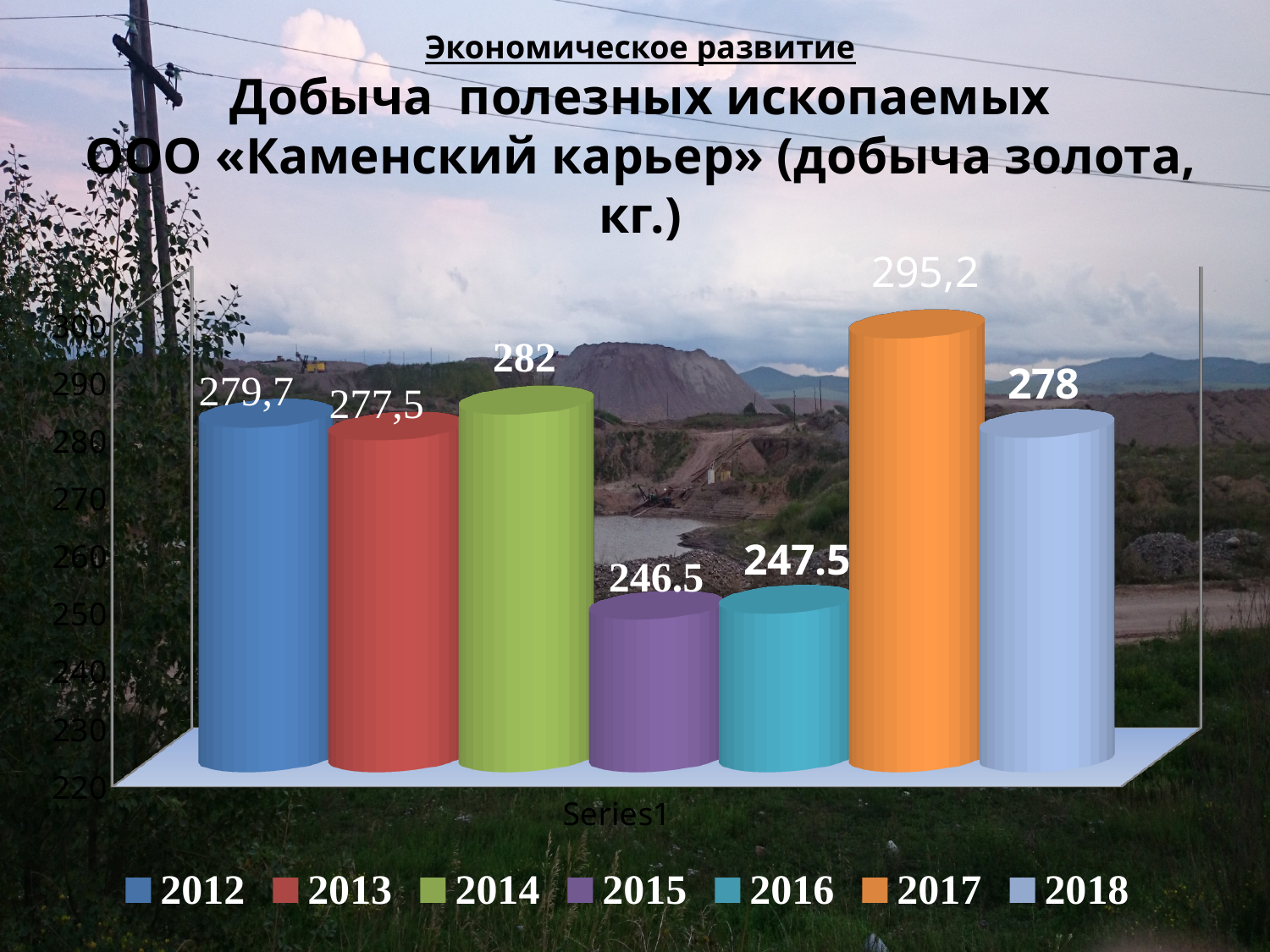
What is the value for 2015? 246.5 How many bars are shown in the chart? 7 What is the difference between the values for 2012 and 2013? 2,2 Which year has the highest value? 2017 How many entries does the legend list? 7 What is the value for 2012? 279,7 What is the value for 2018? 278 Which year has the lowest value? 2015 Which is larger, the value for 2014 or the value for 2016? 2014 What is the difference between the values for 2014 and 2018? 4 What is the value for 2017? 295,2 What kind of chart is shown on the slide? bar chart